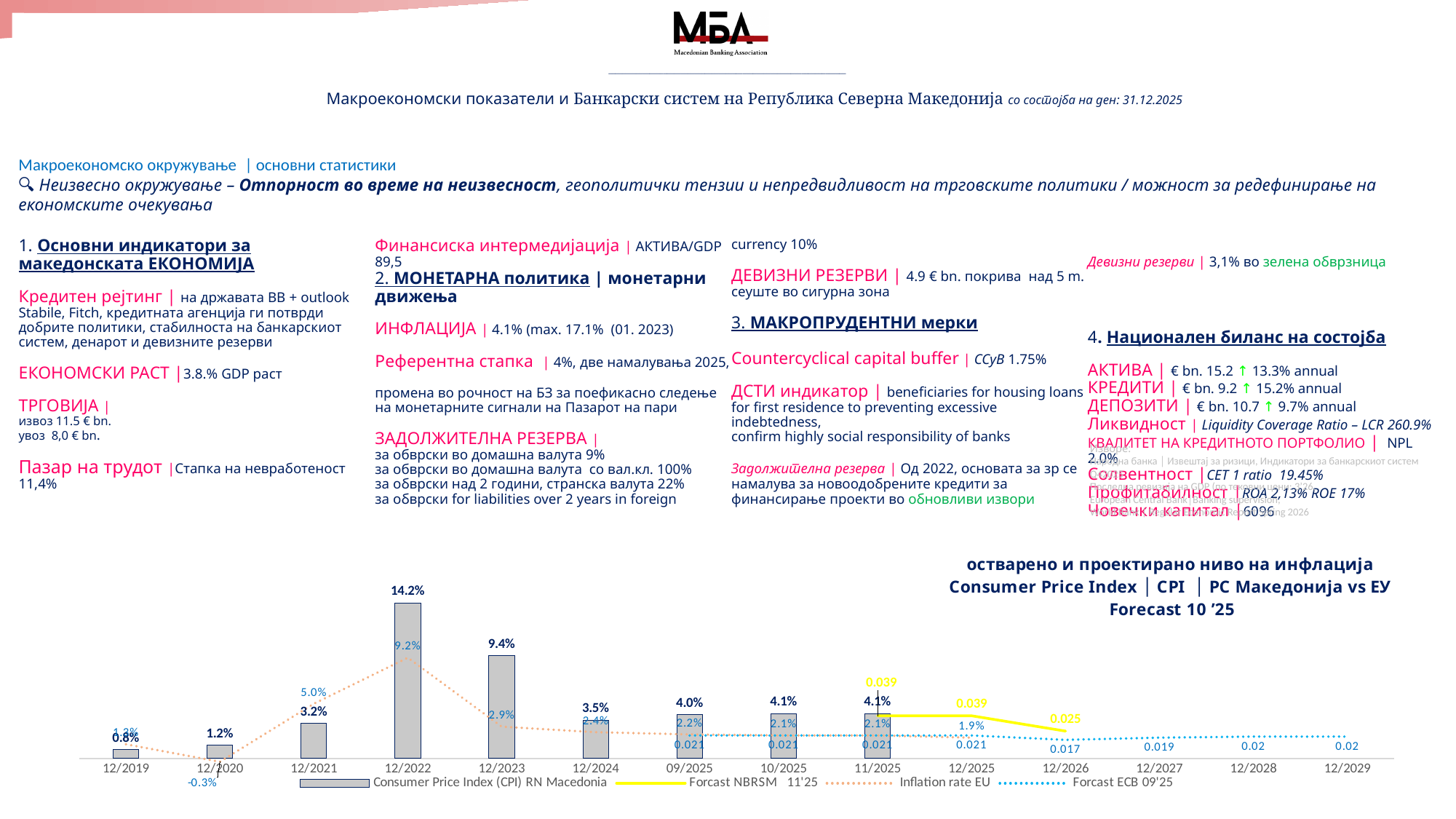
What is the Forcast NBRSM 11'25 value for 12/2026? 0.025 How many series does the chart legend list? 4 Which period has the lowest Consumer Price Index (CPI) RN Macedonia bar? 12/2019 What is the Consumer Price Index (CPI) RN Macedonia value for 12/2022? 14.2% What kind of chart is shown at the bottom of the slide? Combined bar and line chart What is the difference between the CPI RN Macedonia values for 12/2022 and 12/2023? 4.8 percentage points What is the Inflation rate EU value for 12/2021? 5.0% What is the Forcast ECB 09'25 value for 12/2027? 0.019 Do the CPI RN Macedonia bars rise or fall from 12/2022 to 12/2024? Fall Which is larger, the CPI RN Macedonia value for 12/2021 or for 12/2024? 12/2024 How many periods are shown on the x axis of the chart? 14 Which period has the highest Consumer Price Index (CPI) RN Macedonia bar? 12/2022